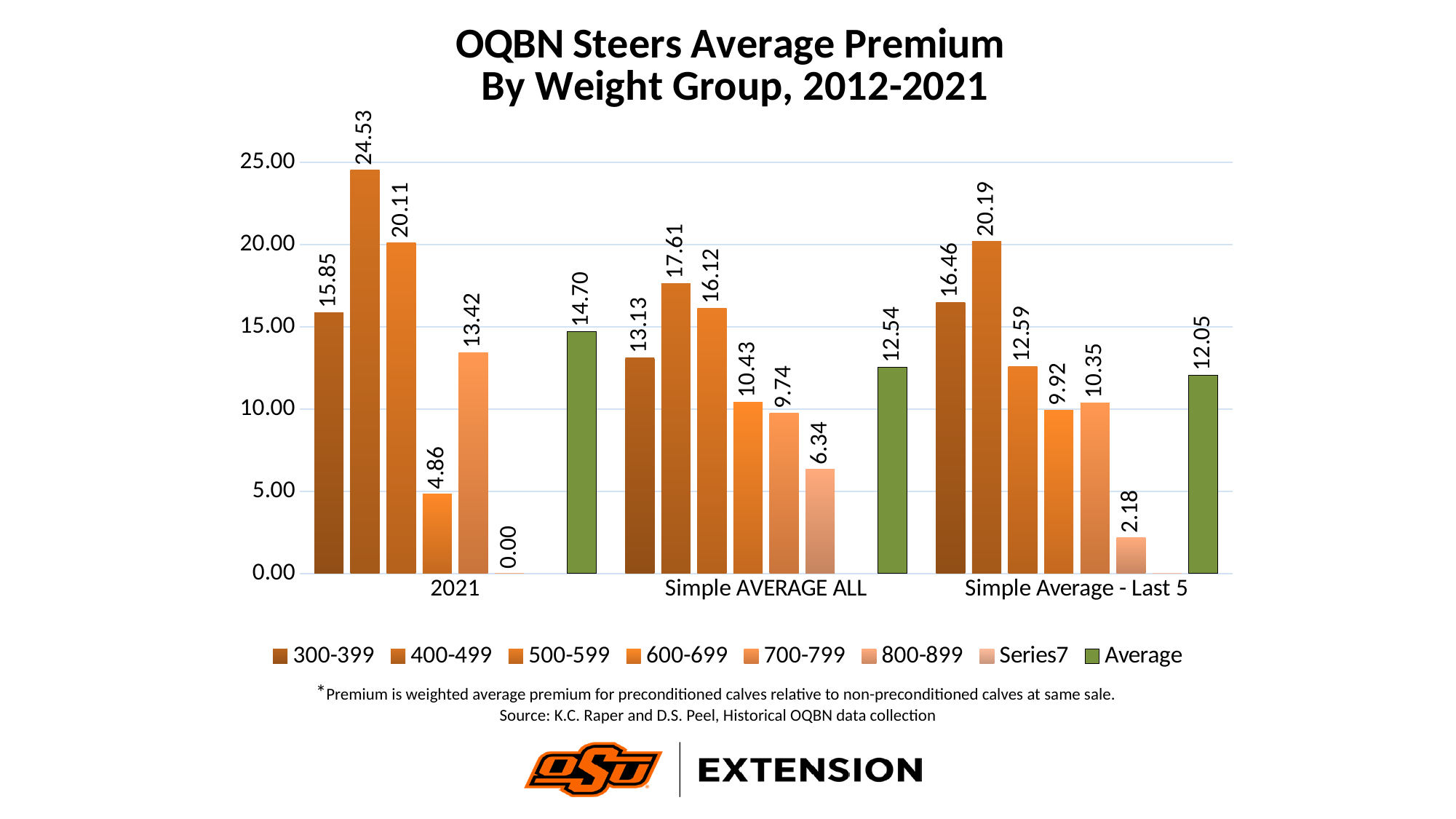
Which weight group has the highest premium in 2021? 400-499 What is the value for the 600-699 weight group in 2021? 4.86 Is the 300-399 value larger in 2021 or in Simple Average - Last 5? Simple Average - Last 5 What is the difference between the 400-499 value in 2021 and the 400-499 value in Simple AVERAGE ALL? 6.92 How many categories are shown on the x axis? 3 Which weight group has the lowest premium in the Simple AVERAGE ALL category? 800-899 What is the value for the 400-499 weight group in 2021? 24.53 How many series does the legend list? 8 What is the difference between the Average value for 2021 and the Average value for Simple AVERAGE ALL? 2.16 What kind of chart is shown on the slide? Bar chart What is the title of the chart? OQBN Steers Average Premium By Weight Group, 2012-2021 What is the Average value for the Simple Average - Last 5 category? 12.05